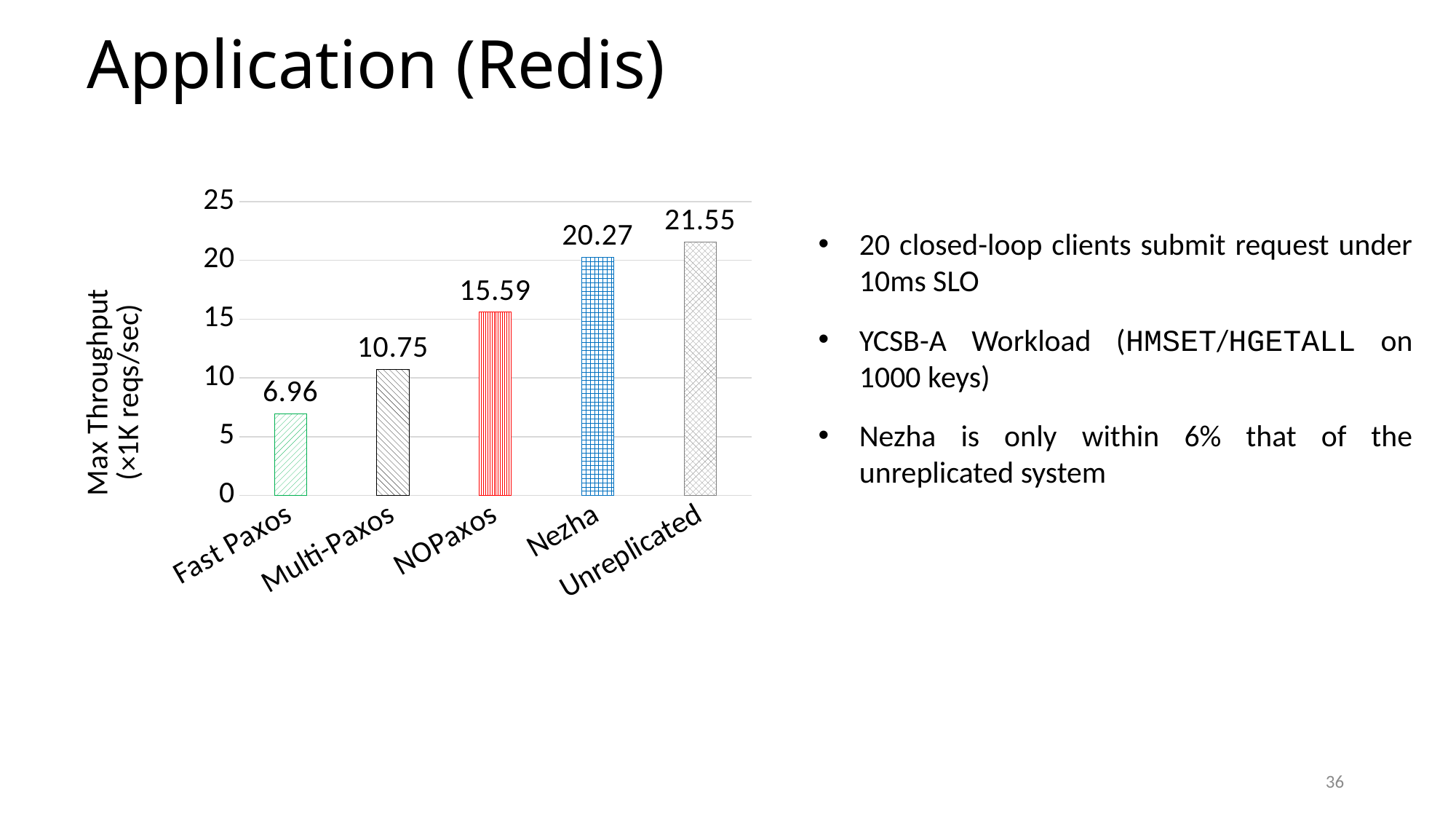
What is the max throughput for Fast Paxos? 6.96 What is the max throughput for Nezha? 20.27 Which system has the highest max throughput? Unreplicated Is the max throughput for Multi-Paxos greater or less than 10? greater What is the max throughput for NOPaxos? 15.59 Which system has the lowest max throughput? Fast Paxos What is the label of the y axis? Max Throughput (×1K reqs/sec) What kind of chart is shown on the slide? Bar chart How many systems are shown on the x axis? 5 What is the difference in max throughput between NOPaxos and Multi-Paxos? 4.84 What is the difference in max throughput between Unreplicated and Nezha? 1.28 Which has a higher max throughput, Multi-Paxos or NOPaxos? NOPaxos